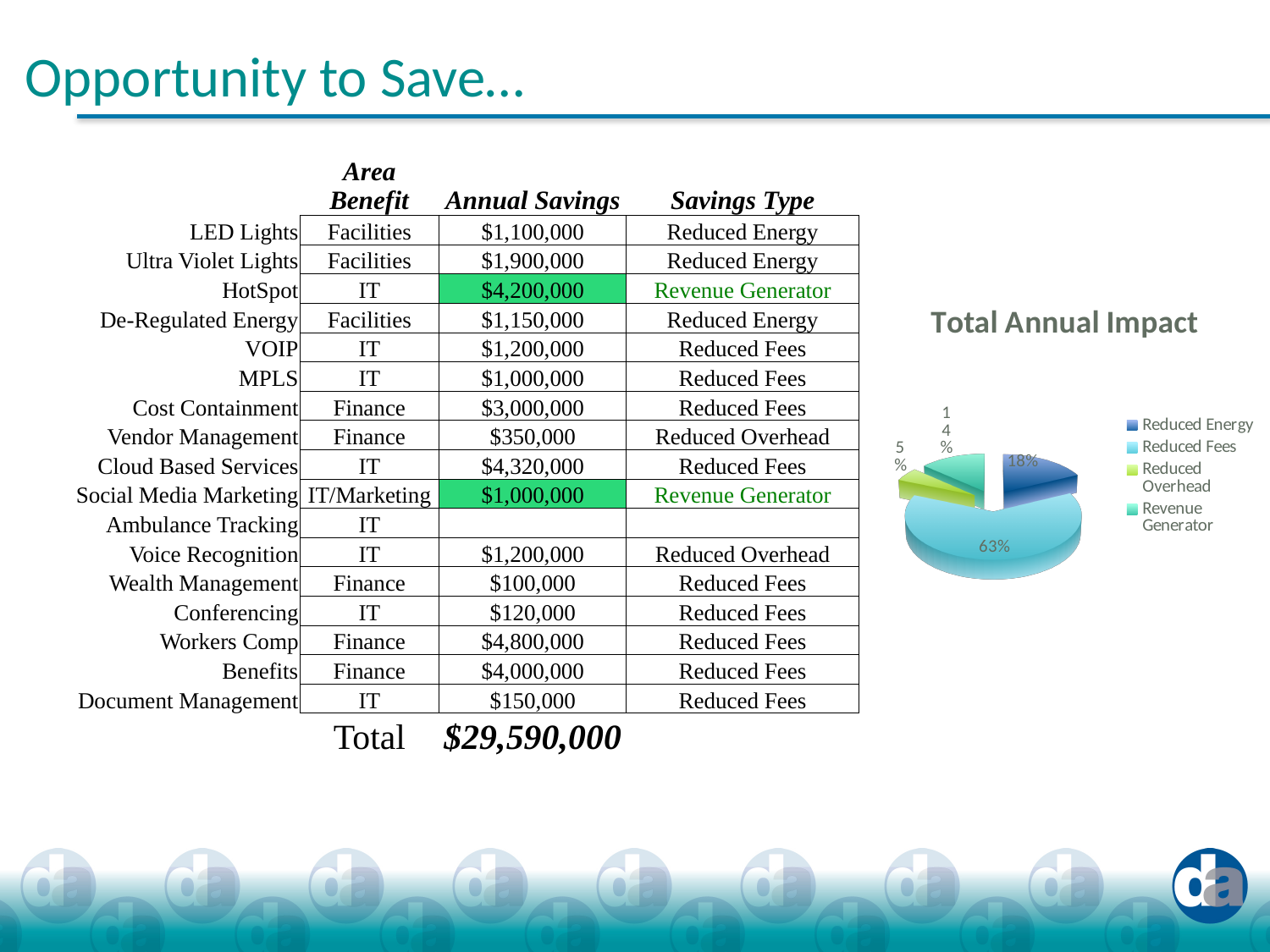
What is the largest percentage label shown on the pie chart? 63% Which has the larger share of the pie, Reduced Fees or Reduced Energy? Reduced Fees Which category has the largest share of the pie chart? Reduced Fees How many slices does the pie chart have? 4 Which legend entry is listed last in the pie chart's legend? Revenue Generator What share of the pie does Reduced Fees account for? 63% What is the difference between the largest and smallest percentage labels on the pie chart? 58% How many categories does the legend of the pie chart list? 4 What kind of chart is shown on the slide? pie chart What is the title of the chart on the slide? Total Annual Impact Is the share for Reduced Fees greater or less than 50%? greater What is the smallest percentage label shown on the pie chart? 5%